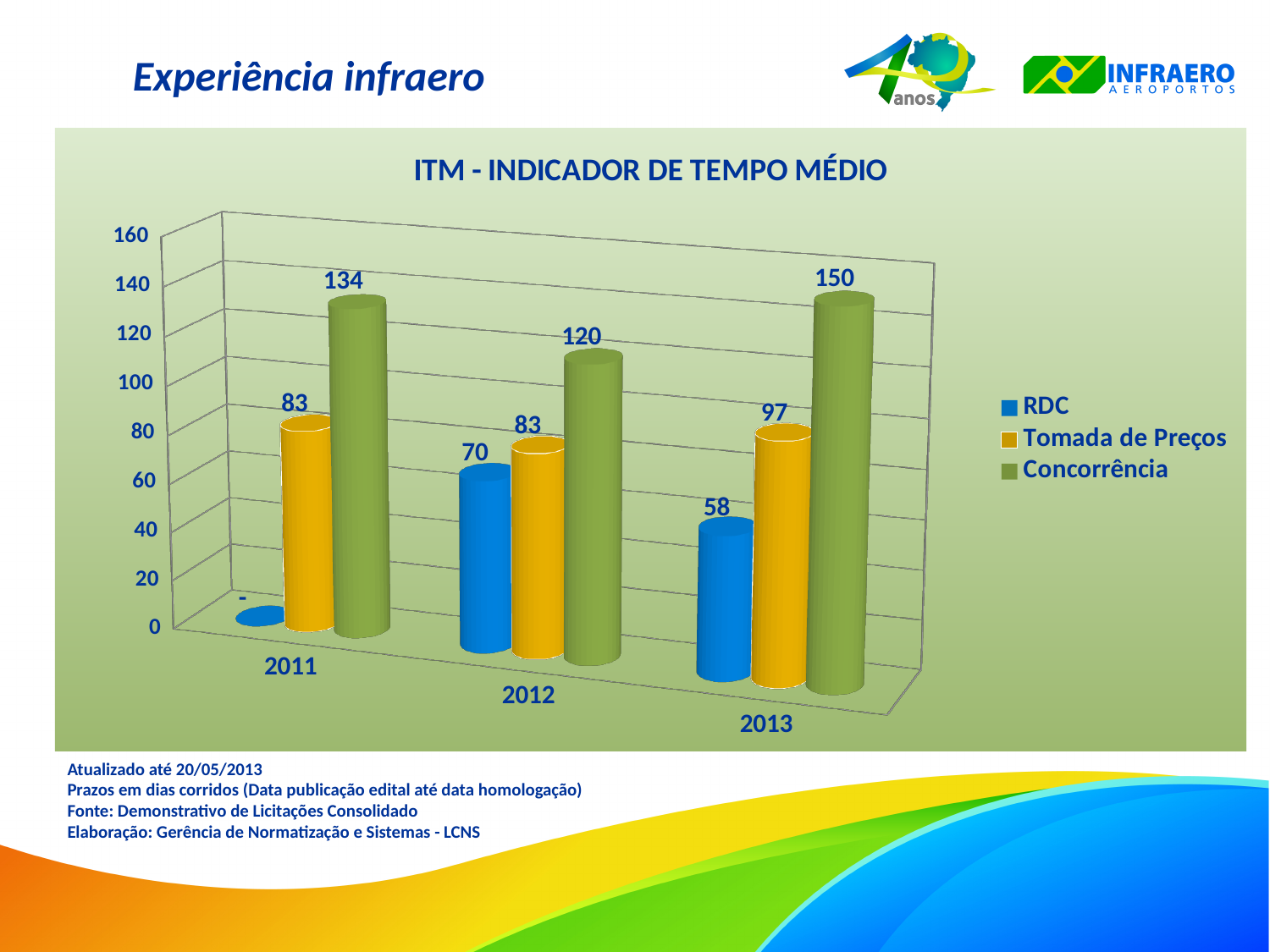
What is the value for Concorrência in 2011? 134 What kind of chart is shown? bar chart In which year is the Concorrência value highest? 2013 How many years are shown on the x axis? 3 What is the title of the chart? ITM - INDICADOR DE TEMPO MÉDIO What is the value for Tomada de Preços in 2013? 97 What is the value for Concorrência in 2013? 150 What is the value for RDC in 2012? 70 Which is larger, the RDC value in 2012 or in 2013? 2012 In which year is the Concorrência value lowest? 2012 How many series does the legend list? 3 What is the difference between the Concorrência values for 2013 and 2012? 30